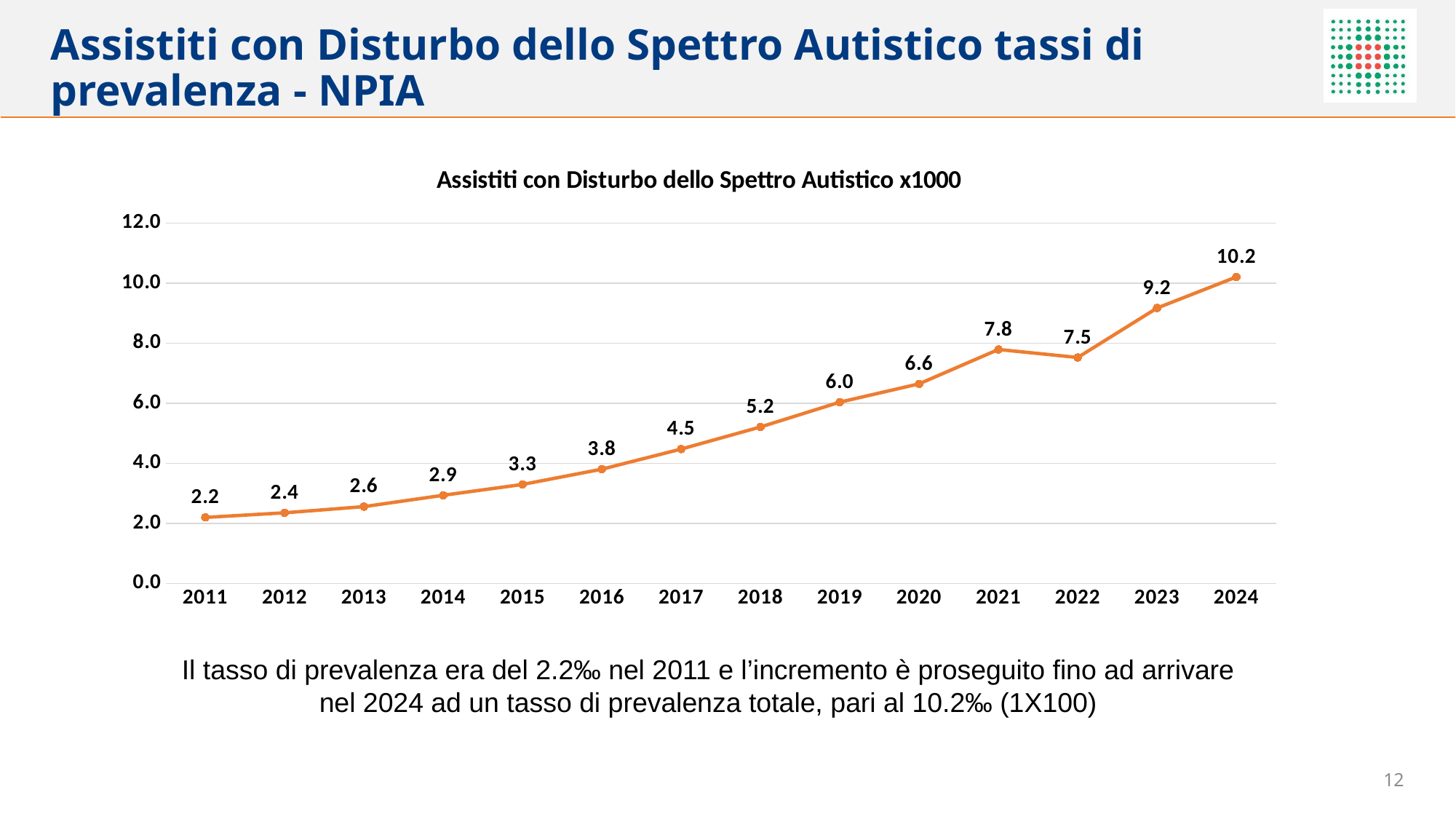
How many years are plotted on the chart? 14 Which year has the highest value? 2024 What kind of chart is shown on the slide? line chart What is the value for 2019? 6.0 What is the difference between the values for 2024 and 2011? 8.0 Which year has the lowest value? 2011 What is the value for 2022? 7.5 What is the value for 2011? 2.2 Is the value for 2023 greater or less than 8.0? greater What is the title of the chart? Assistiti con Disturbo dello Spettro Autistico x1000 Which is larger, the value for 2021 or the value for 2022? 2021 What is the difference between the values for 2021 and 2022? 0.3